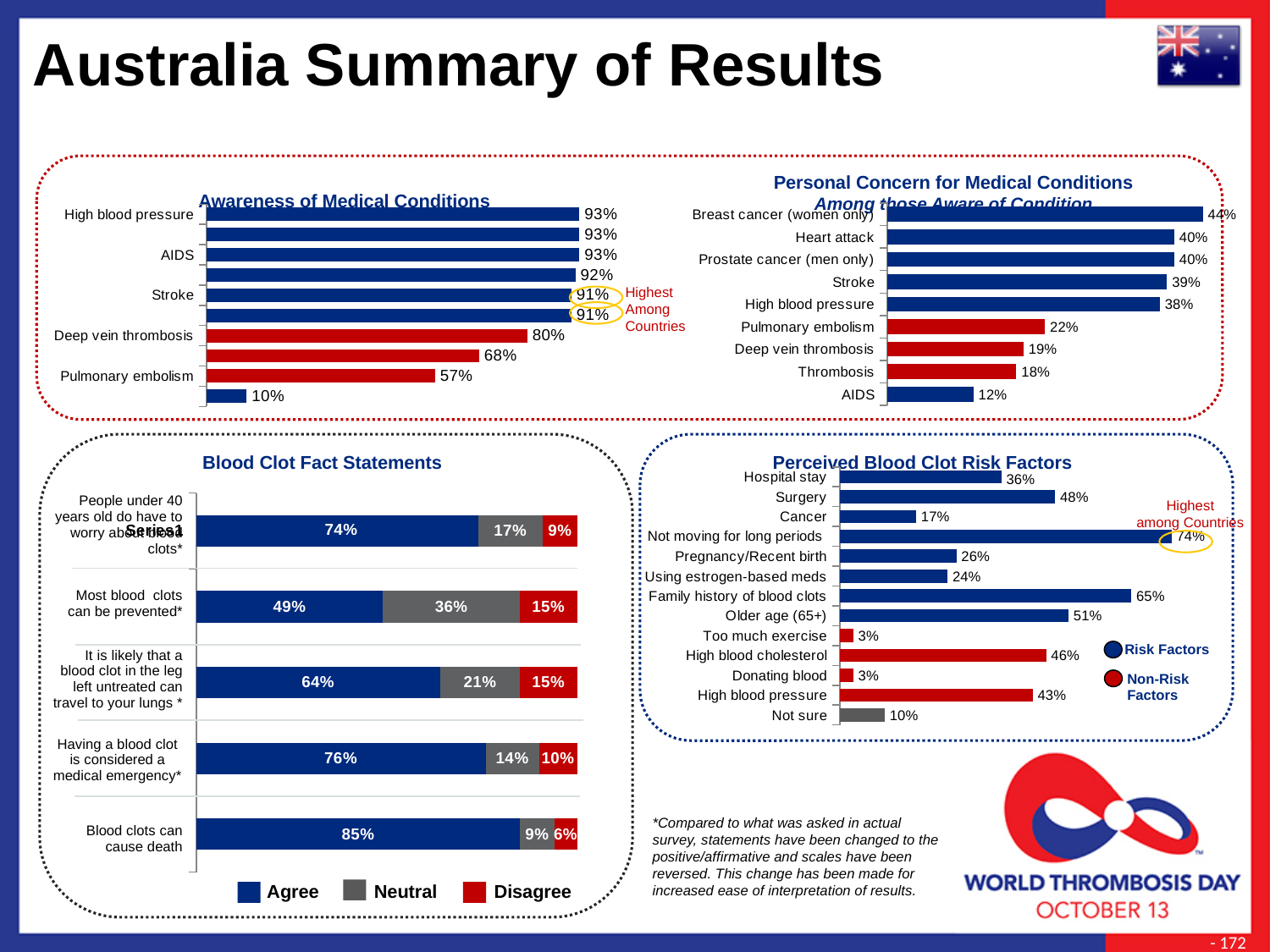
In the Perceived Blood Clot Risk Factors chart, how many categories are shown? 13 In the Blood Clot Fact Statements chart, what is the Neutral value for 'Most blood clots can be prevented'? 36% In the Perceived Blood Clot Risk Factors chart, what is the value for Not moving for long periods? 74% In the Personal Concern for Medical Conditions chart, which condition has the lowest value? AIDS In the Personal Concern for Medical Conditions chart, what is the value for Heart attack? 40% In the Personal Concern for Medical Conditions chart, what is the difference between Stroke and Deep vein thrombosis? 20% How many series does the legend of the Blood Clot Fact Statements chart list? 3 In the Personal Concern for Medical Conditions chart, which condition has the highest value? Breast cancer (women only) What kind of chart is the Awareness of Medical Conditions chart? Bar chart In the Perceived Blood Clot Risk Factors chart, which is larger, Surgery or High blood cholesterol? Surgery In the Personal Concern for Medical Conditions chart, how many conditions are listed? 9 In the Blood Clot Fact Statements chart, what percentage agree that blood clots can cause death? 85%